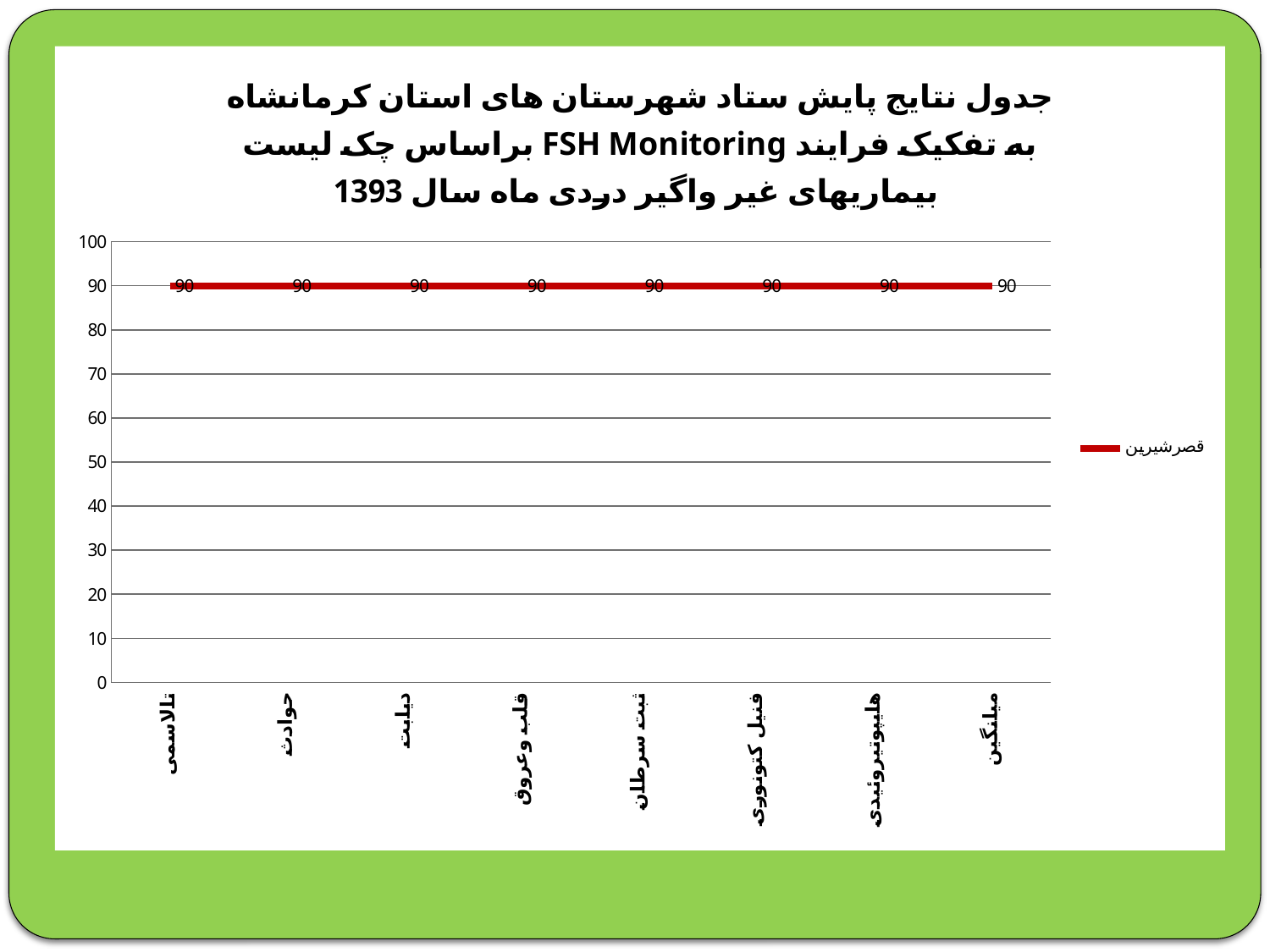
What kind of chart is this? line chart What colour is the plotted line? red What is the value for ثبت سرطان? 90 How many series does the legend list? 1 What is the value for میانگین? 90 What is the value for تالاسمی? 90 What series name is shown in the legend? قصرشیرین How many categories are shown on the x axis? 8 Is the value for قلب و عروق greater or less than 80? greater What is the value for هیپوتیروئیدی? 90 What is the difference between the values for دیابت and حوادث? 0 Do the values rise, fall, or stay flat across the categories? stay flat